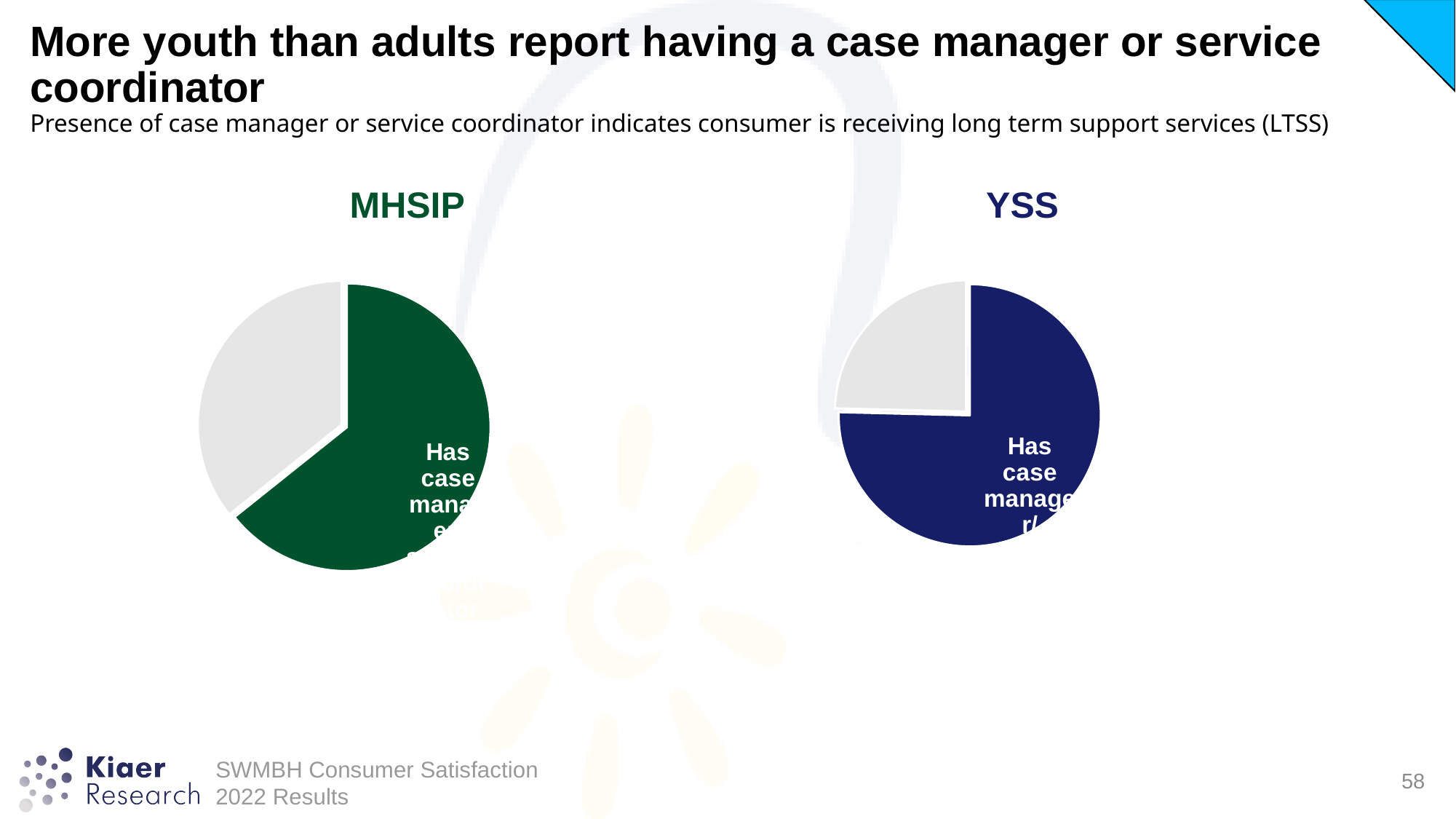
What kind of chart is used for the MHSIP data on the slide? Pie chart How many slices does the YSS pie chart have? 2 How many pie charts are shown on the slide? 2 In the MHSIP pie chart, is the 'Has case manager' slice larger or smaller than the other slice? Larger What colour is the 'Has case manager' slice in the MHSIP pie chart? Dark green What kind of chart is used for the YSS data on the slide? Pie chart Which pie chart, MHSIP or YSS, shows a larger grey slice? MHSIP What are the titles of the two pie charts on the slide? MHSIP and YSS How many slices does the MHSIP pie chart have? 2 In the YSS pie chart, is the 'Has case manager' slice larger or smaller than the other slice? Larger